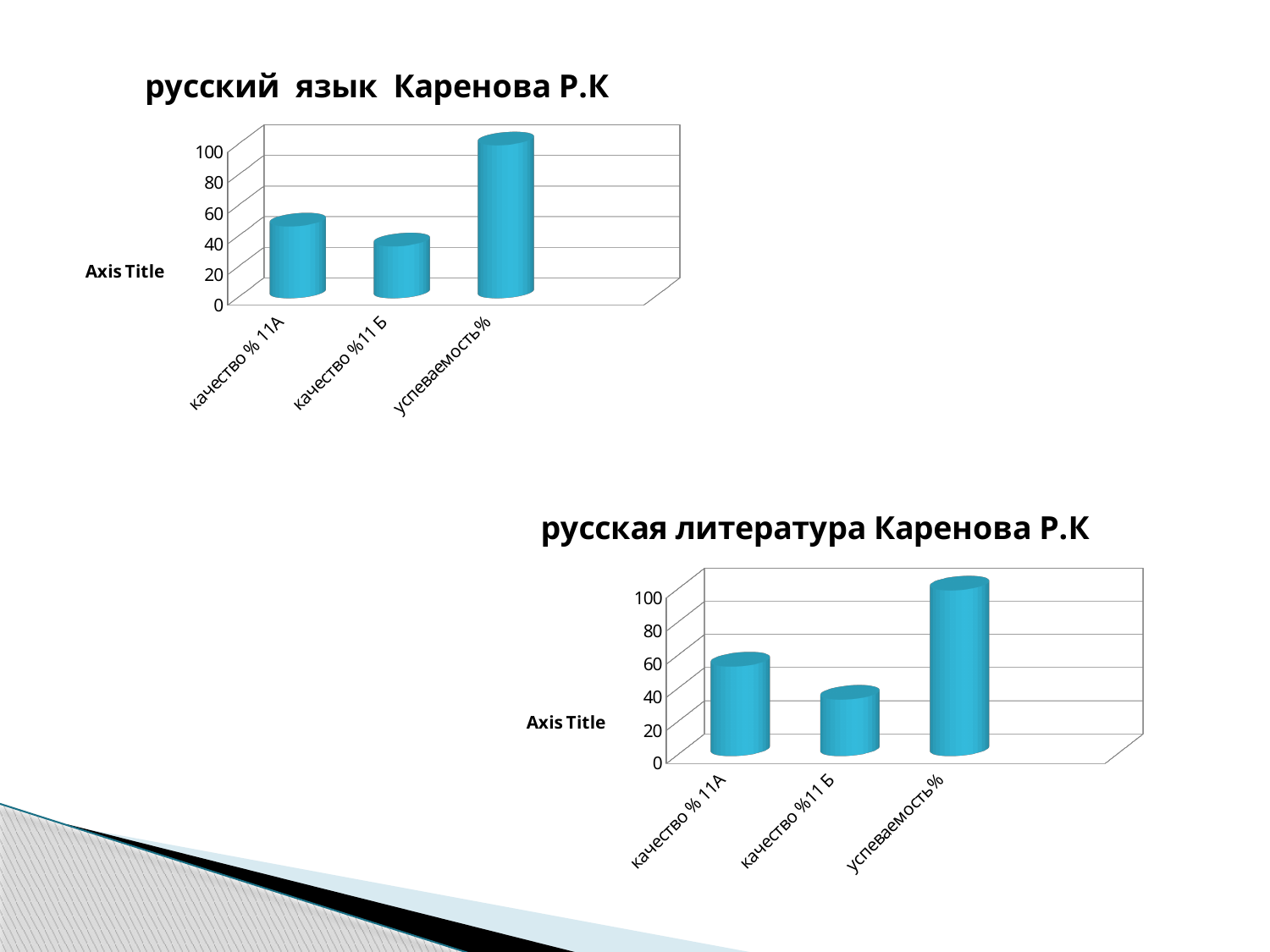
In the chart titled 'русская литература Каренова Р.К', is the value for качество % 11А greater or less than 40? greater In the chart titled 'русская литература Каренова Р.К', which category has the highest bar? успеваемость% In the chart titled 'русский язык Каренова Р.К', which category has the highest bar? успеваемость% In the chart titled 'русская литература Каренова Р.К', which is larger, качество % 11А or качество %11 Б? качество % 11А In the chart titled 'русский язык Каренова Р.К', is the value for успеваемость% greater or less than 80? greater In the chart titled 'русская литература Каренова Р.К', which category has the lowest bar? качество %11 Б In the chart titled 'русская литература Каренова Р.К', is the value for успеваемость% greater or less than 80? greater What is the title of the lower chart on the slide? русская литература Каренова Р.К In the chart titled 'русский язык Каренова Р.К', which category has the lowest bar? качество %11 Б In the chart titled 'русский язык Каренова Р.К', how many categories are shown on the x axis? 3 What type of chart is the one titled 'русский язык Каренова Р.К'? bar chart